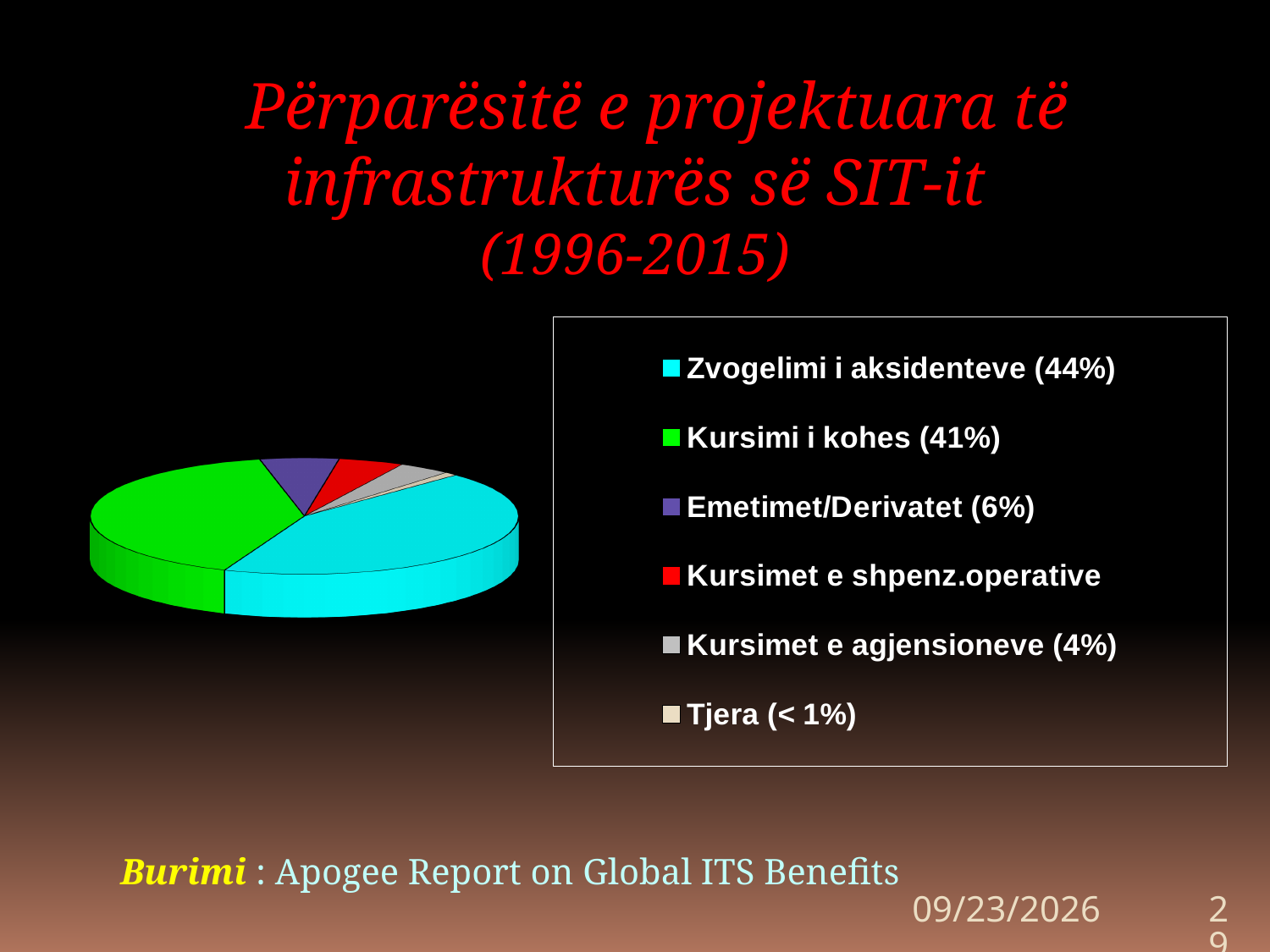
What kind of chart is shown on the slide? pie chart What share of the pie does Kursimi i kohes represent? 41% What is the source cited below the chart? Apogee Report on Global ITS Benefits Which category has the smallest slice of the pie? Tjera What colour is the slice for Kursimi i kohes? green Which category has the largest slice of the pie? Zvogelimi i aksidenteve What share of the pie does Kursimet e agjensioneve represent? 4% Which is larger, the share for Zvogelimi i aksidenteve or the share for Kursimi i kohes? Zvogelimi i aksidenteve How many slices does the pie chart have? 6 What share of the pie does Zvogelimi i aksidenteve represent? 44% By how many percentage points does the share for Zvogelimi i aksidenteve exceed the share for Kursimi i kohes? 3